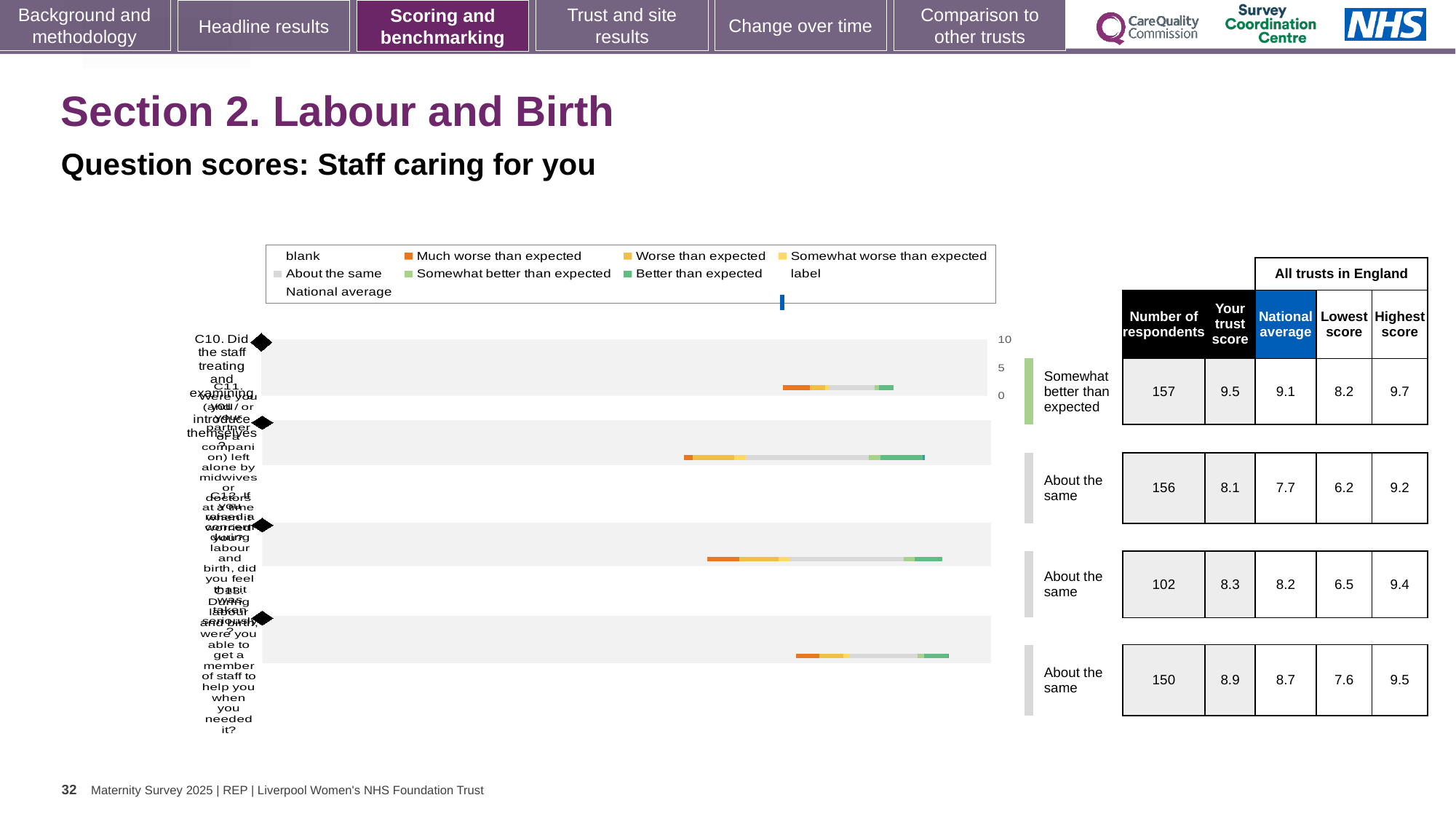
For question C11, which is larger: the trust score or the national average? the trust score How many questions (rows) are plotted in the chart? 4 What is the 'Your trust score' for question C10? 9.5 What is the lowest score among all trusts in England for question C12? 6.5 What is the national average for question C11? 7.7 Which question has the highest 'Your trust score'? C10 Which question has the lowest number of respondents? C12 How many respondents are there for question C12? 102 What is the highest score among all trusts in England for question C13? 9.5 What is the difference between the trust score and the national average for question C10? 0.4 What kind of chart is shown on the slide? bar chart What benchmark category is shown for question C10? Somewhat better than expected